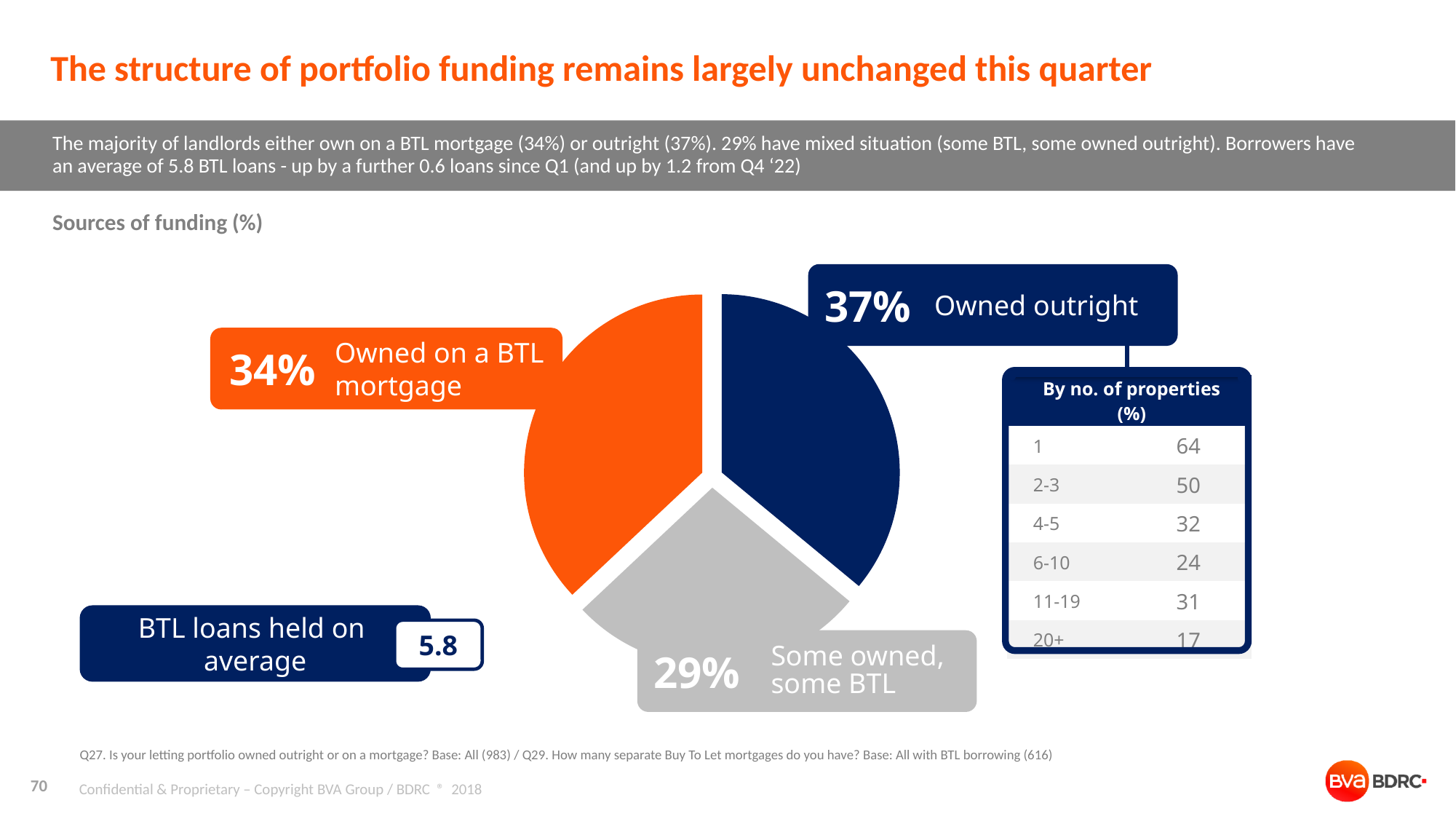
What is the difference in percentage points between "Owned outright" and "Owned on a BTL mortgage"? 3 percentage points What colour is the "Owned on a BTL mortgage" slice in the pie chart? Orange What is the difference in percentage points between "Owned on a BTL mortgage" and "Some owned, some BTL"? 5 percentage points What percentage is shown for "Owned on a BTL mortgage" in the pie chart? 34% What percentage is shown for "Some owned, some BTL" in the pie chart? 29% Which slice of the pie chart is the largest? Owned outright Which is larger in the pie chart: "Owned outright" or "Owned on a BTL mortgage"? Owned outright Which slice of the pie chart is the smallest? Some owned, some BTL What kind of chart is shown under "Sources of funding (%)"? Pie chart What percentage of landlords own their portfolio outright according to the pie chart? 37% What is the title of the pie chart? Sources of funding (%) How many slices does the pie chart have? 3